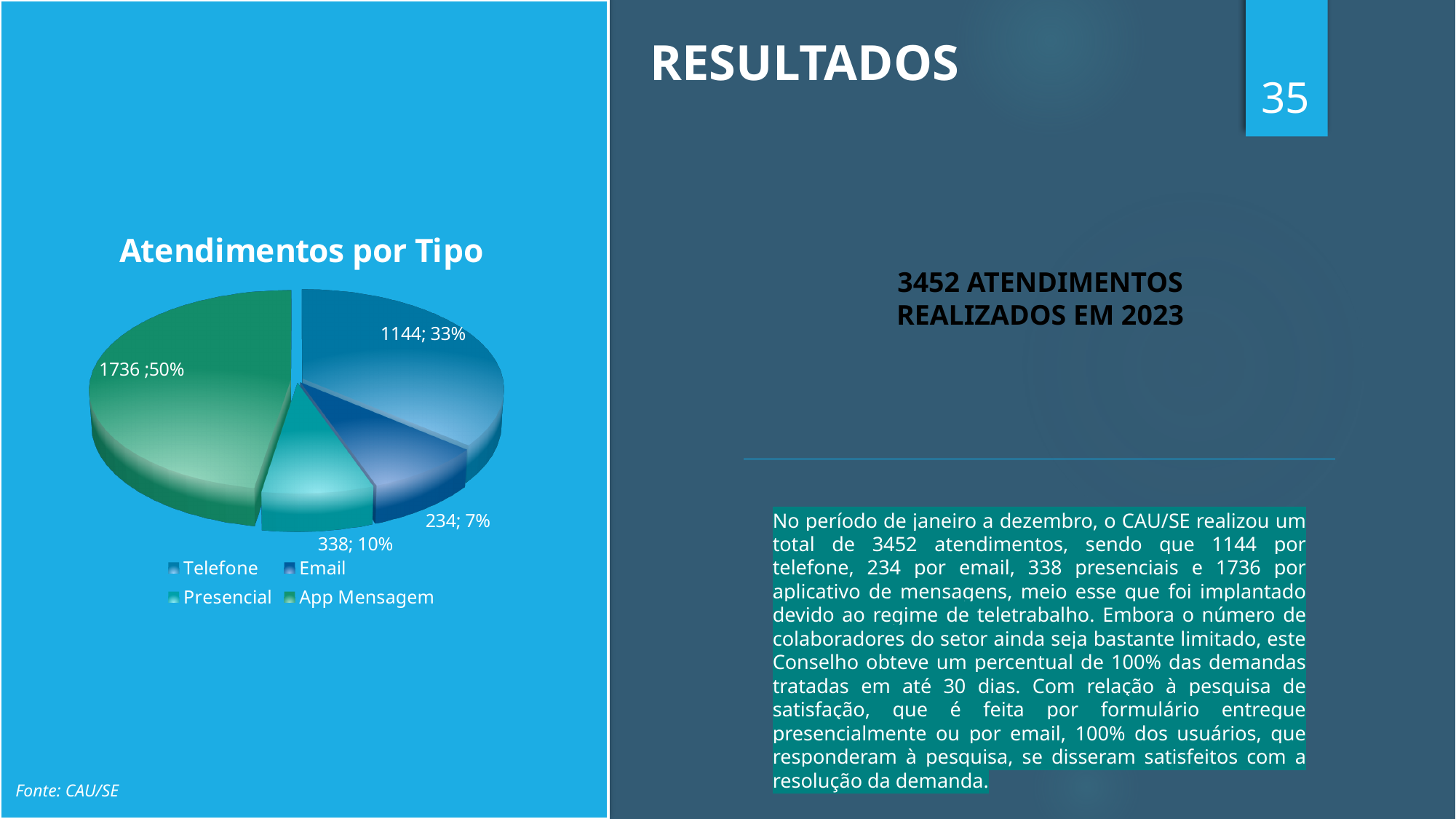
Which is larger, the value for Presencial or the value for Email? Presencial Which category has the smallest slice of the pie? Email What is the title of the chart? Atendimentos por Tipo What is the value for Presencial in the pie chart? 338 What is the value for Email in the pie chart? 234 Which category has the largest slice of the pie? App Mensagem What type of chart is shown on the slide? Pie chart How many entries does the chart legend list? 4 What share of the pie does App Mensagem represent? 50% How many categories does the pie chart show? 4 What is the value for Telefone in the pie chart? 1144 What is the difference between the values for App Mensagem and Telefone? 592